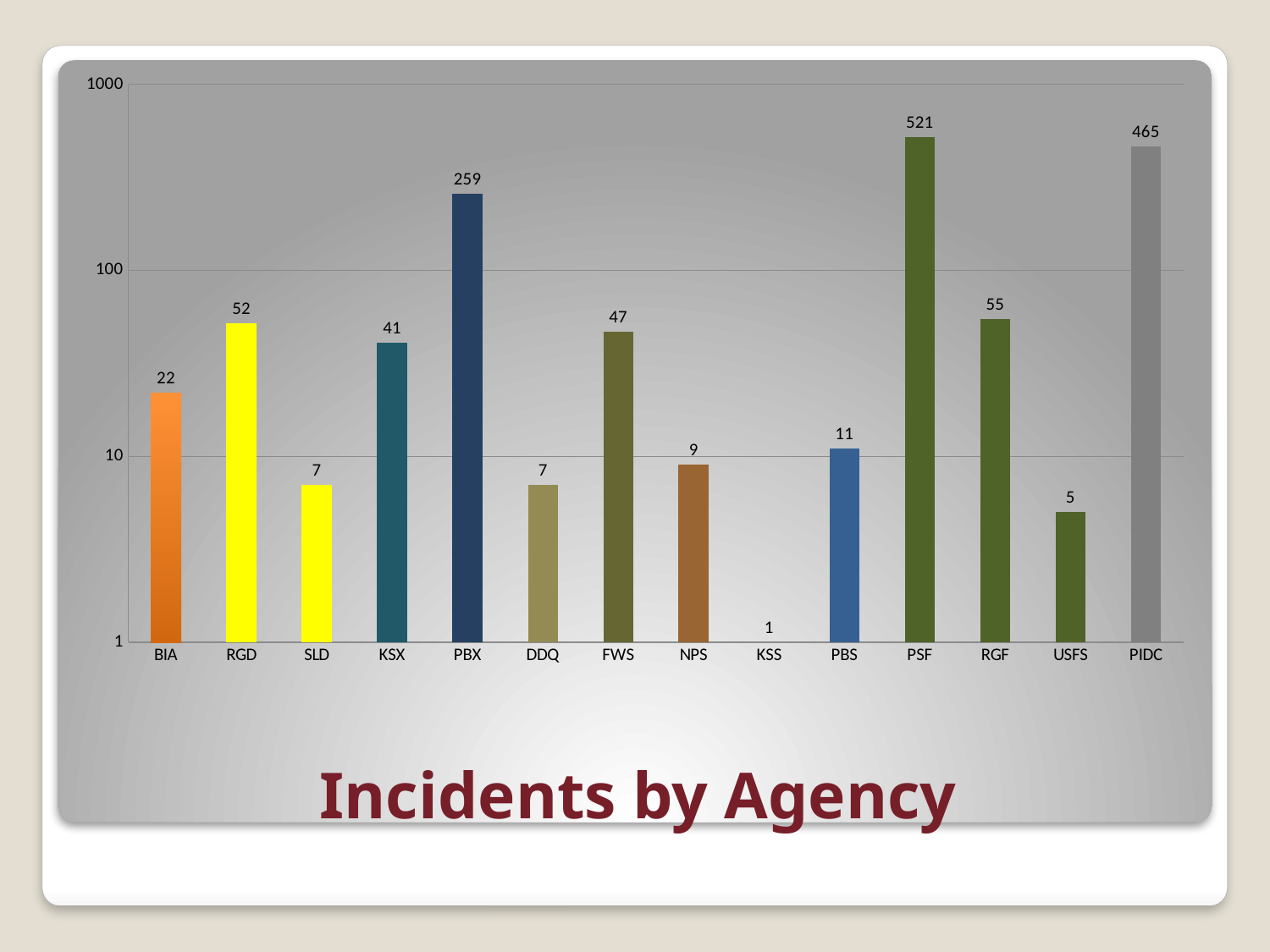
What is the difference between the values for PSF and PIDC? 56 Which agency has the highest number of incidents? PSF What kind of chart is shown on the slide? bar chart What is the title of the chart? Incidents by Agency Which is larger, the value for RGD or the value for RGF? RGF What is the value for KSS? 1 Is the value for FWS greater or less than 10? greater How many agencies are shown on the x axis? 14 What is the value for PBX? 259 Which agency has the lowest number of incidents? KSS What is the value for PSF? 521 What is the highest tick value shown on the y axis? 1000